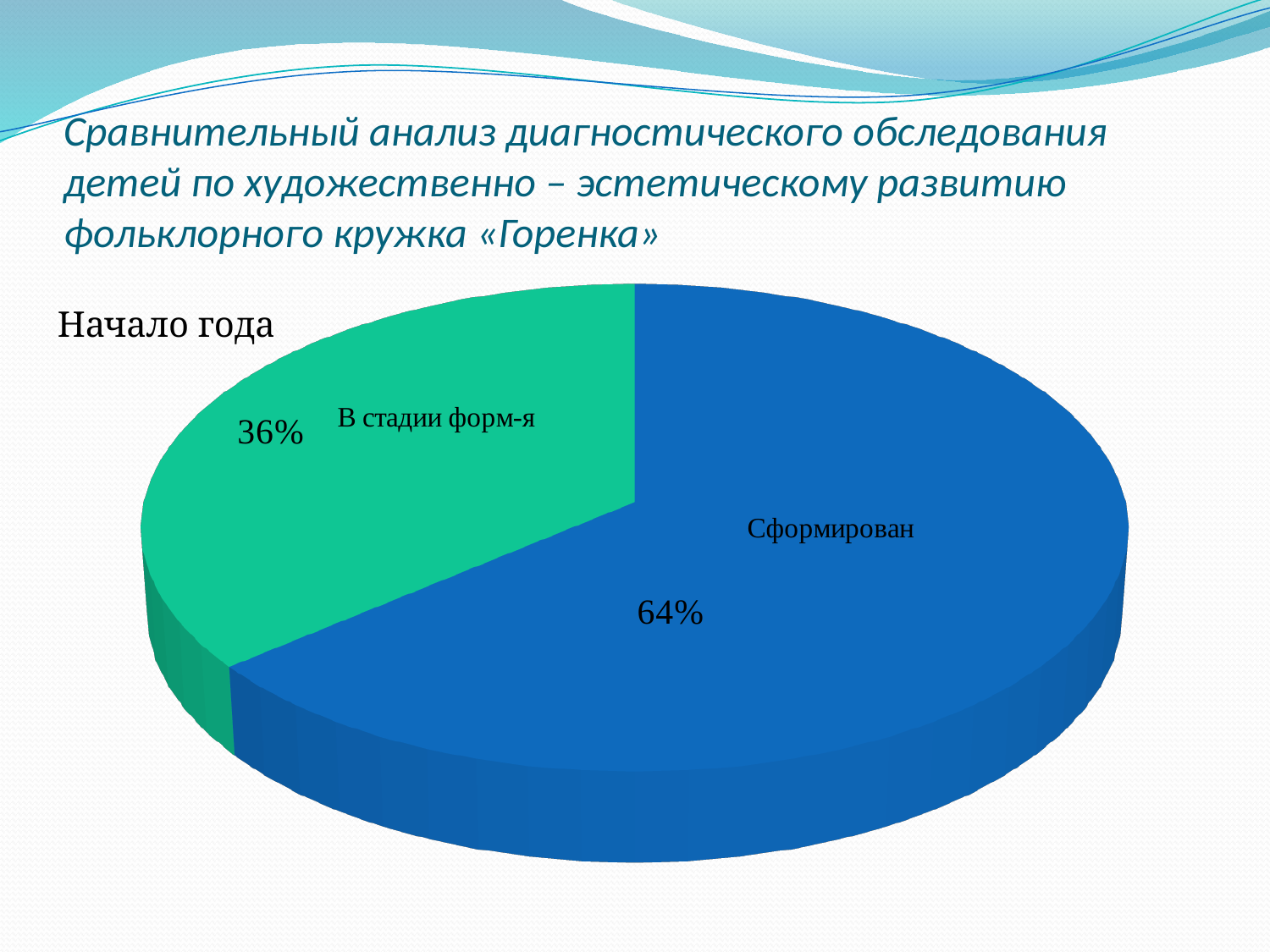
Which slice is the largest in the pie chart? Сформирован What share of the pie does the "В стадии форм-я" slice represent? 36% What is the difference in percentage points between the "Сформирован" and "В стадии форм-я" slices? 28 Which is larger: the "Сформирован" slice or the "В стадии форм-я" slice? Сформирован Is the value for "Сформирован" greater or less than 50%? greater What is the total of the two slice percentages shown? 100% Which slice is the smallest in the pie chart? В стадии форм-я What share of the pie does the "Сформирован" slice represent? 64% What colour is the "Сформирован" slice? Blue What period label is shown next to the pie chart? Начало года How many slices does the pie chart have? 2 What kind of chart is shown on the slide? Pie chart